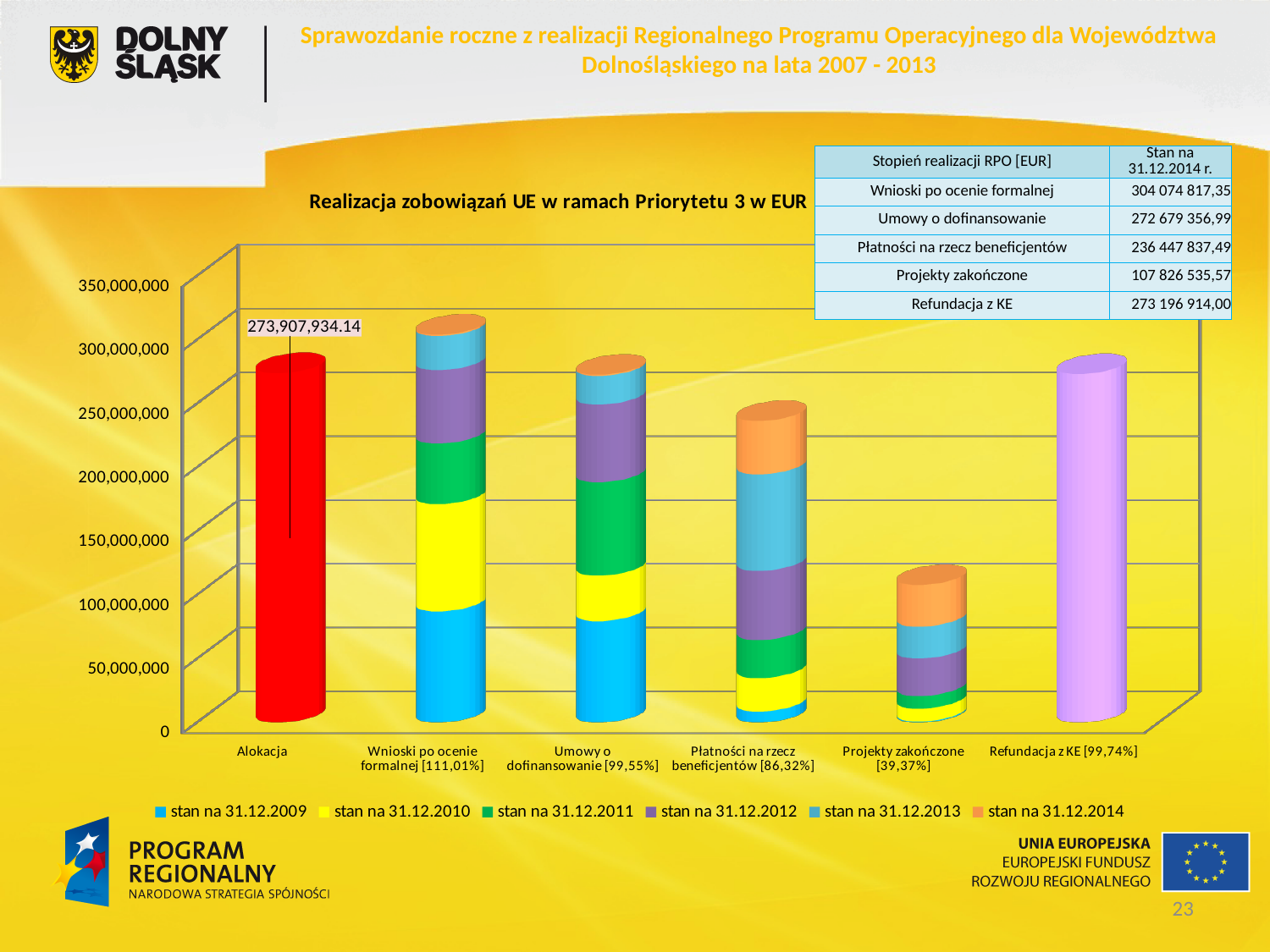
How many categories are shown along the x axis of the chart? 6 What value is labelled on the Alokacja bar? 273,907,934.14 What type of chart is shown on the slide? stacked bar chart Which bar is taller: Umowy o dofinansowanie or Płatności na rzecz beneficjentów? Umowy o dofinansowanie What is the first series listed in the chart legend? stan na 31.12.2009 What percentage is shown in the x-axis label for Projekty zakończone? 39,37% Is the total for Umowy o dofinansowanie greater or less than 250,000,000? greater What is the title of the chart? Realizacja zobowiązań UE w ramach Priorytetu 3 w EUR Which category has the shortest bar in the chart? Projekty zakończone How many series does the chart legend list? 6 Which category has the tallest bar in the chart? Wnioski po ocenie formalnej